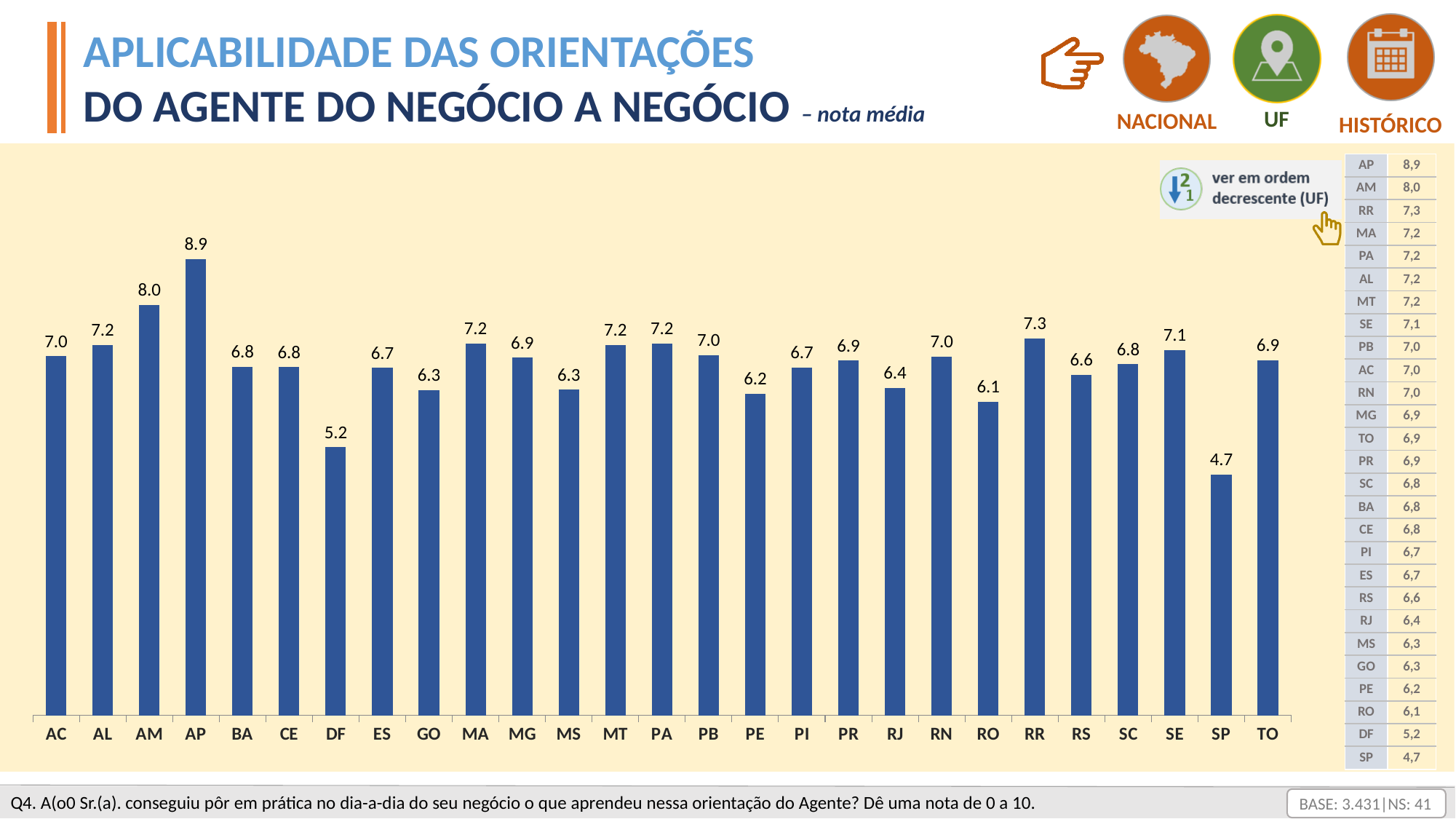
What is the value shown for AP? 8.9 What is the difference between the values for AM and DF? 2.8 What is the value shown for DF? 5.2 How many states (categories) are shown on the x axis of the chart? 27 Which is larger, the value for AM or the value for RR? AM What is the value shown for RR? 7.3 Which is larger, the value for RJ or the value for RS? RS What is the difference between the values for AP and SP? 4.2 Which state has the lowest value in the chart? SP What type of chart is shown on the slide? Bar chart What is the value shown for SE? 7.1 Which state has the highest value in the chart? AP